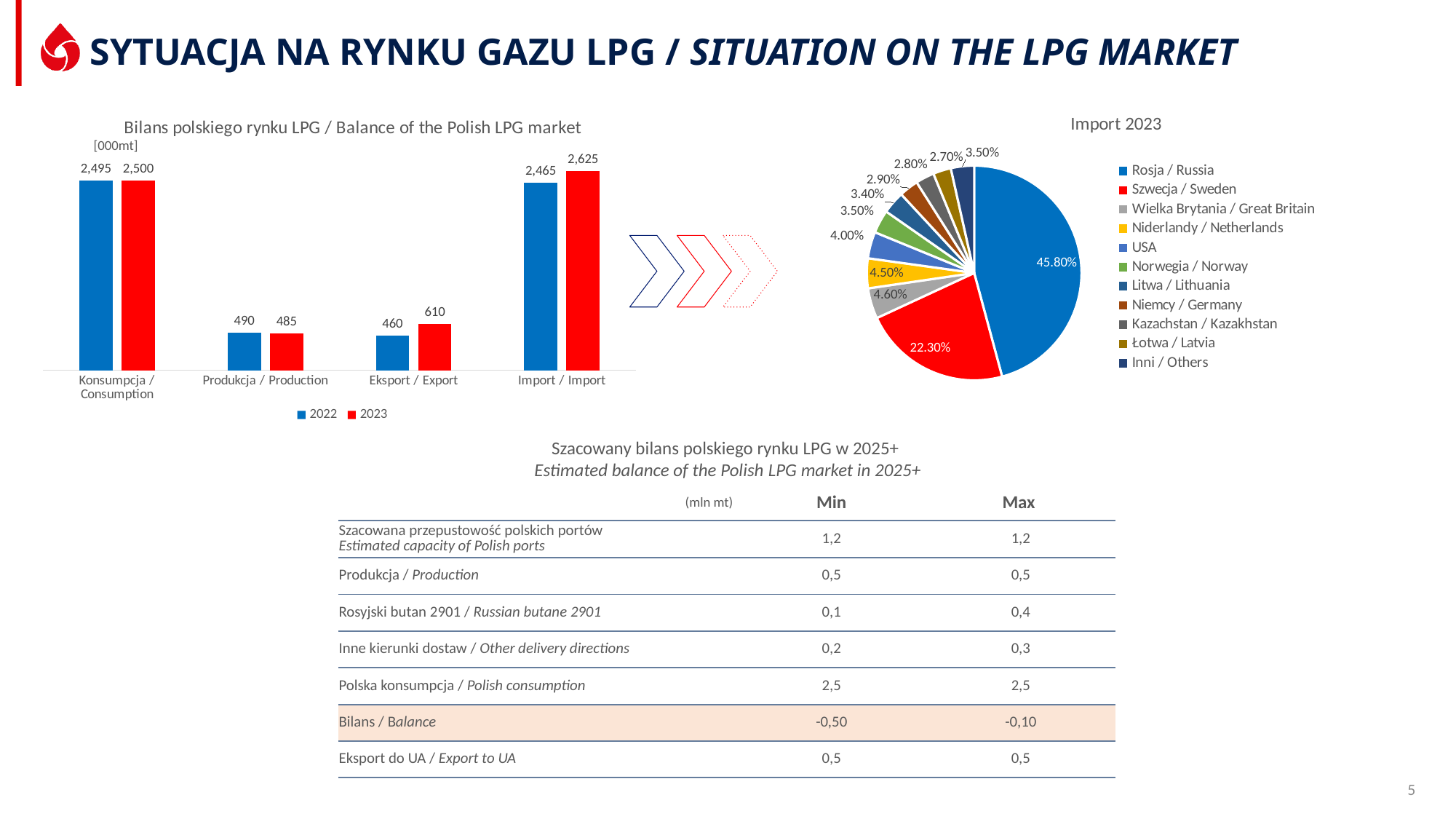
In the bar chart 'Balance of the Polish LPG market', what is the difference between the 2023 and 2022 values for Eksport / Export? 150 In the bar chart 'Balance of the Polish LPG market', what is the value for Import in 2023? 2,625 How many entries does the legend of the pie chart 'Import 2023' list? 11 In the pie chart 'Import 2023', what share does Rosja / Russia have? 45.80% How many series does the legend of the bar chart 'Balance of the Polish LPG market' list? 2 In the bar chart 'Balance of the Polish LPG market', is the 2022 value for Produkcja / Production larger or smaller than the 2023 value? larger In the bar chart 'Balance of the Polish LPG market', what is the value for Eksport / Export in 2022? 460 What kind of chart is 'Import 2023'? pie chart What unit is shown on the bar chart 'Balance of the Polish LPG market'? [000mt] In the pie chart 'Import 2023', what share does Szwecja / Sweden have? 22.30% In the bar chart 'Balance of the Polish LPG market', which category has the lowest value for 2023? Produkcja / Production In the pie chart 'Import 2023', which country has the largest share? Rosja / Russia